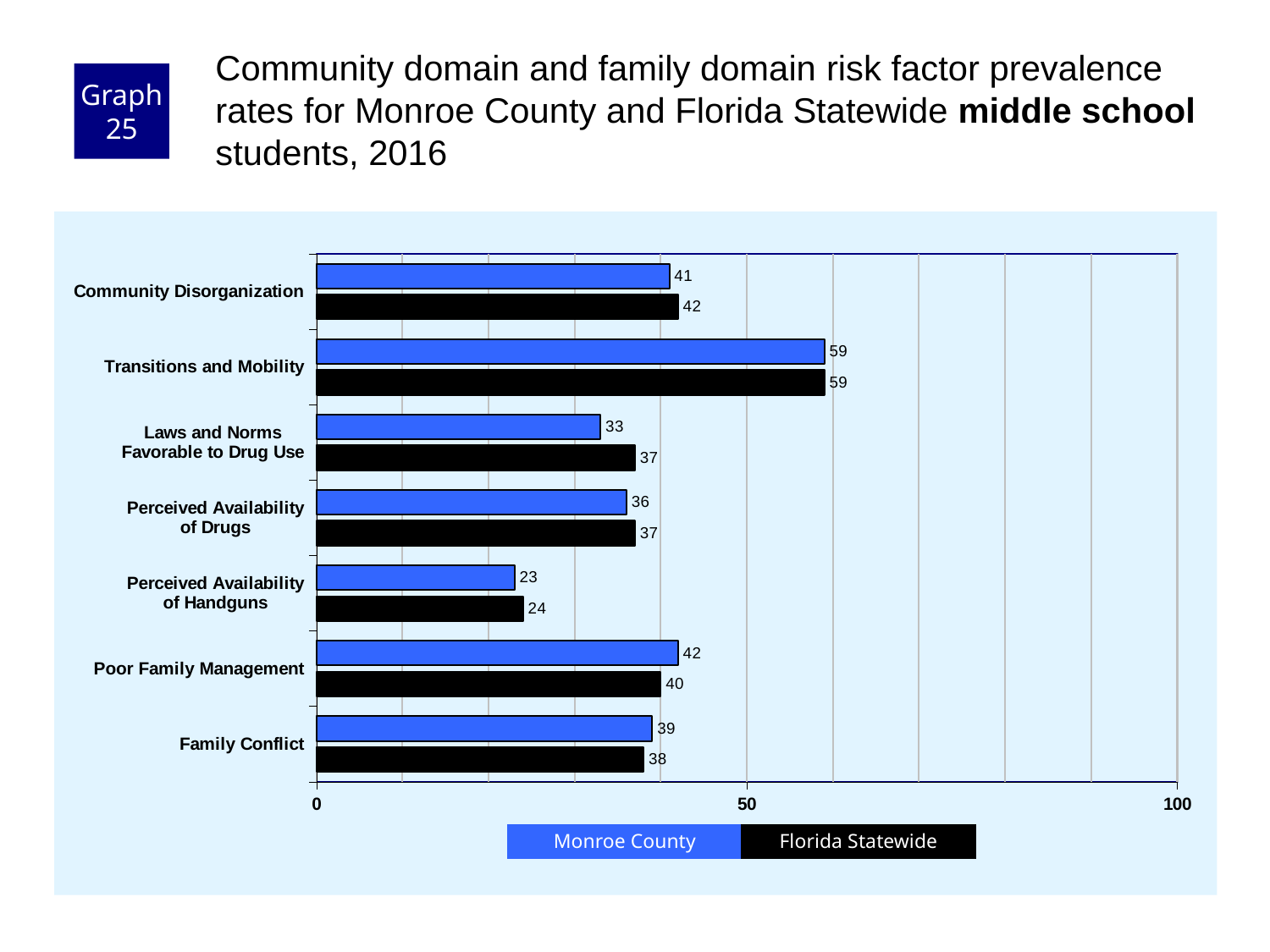
Which colour represents Florida Statewide in the chart? black What kind of chart is shown on the slide? bar chart What is the Monroe County value for Transitions and Mobility? 59 Which risk factor has the highest Monroe County value? Transitions and Mobility What is the Monroe County value for Perceived Availability of Handguns? 23 How many risk factors are shown on the chart? 7 What is the Florida Statewide value for Laws and Norms Favorable to Drug Use? 37 What is the difference between the Florida Statewide and Monroe County values for Laws and Norms Favorable to Drug Use? 4 Which risk factor has the lowest Florida Statewide value? Perceived Availability of Handguns How many series does the legend list? 2 For Poor Family Management, which is larger: the Monroe County value or the Florida Statewide value? Monroe County Is the Monroe County value for Community Disorganization greater or less than 50? less